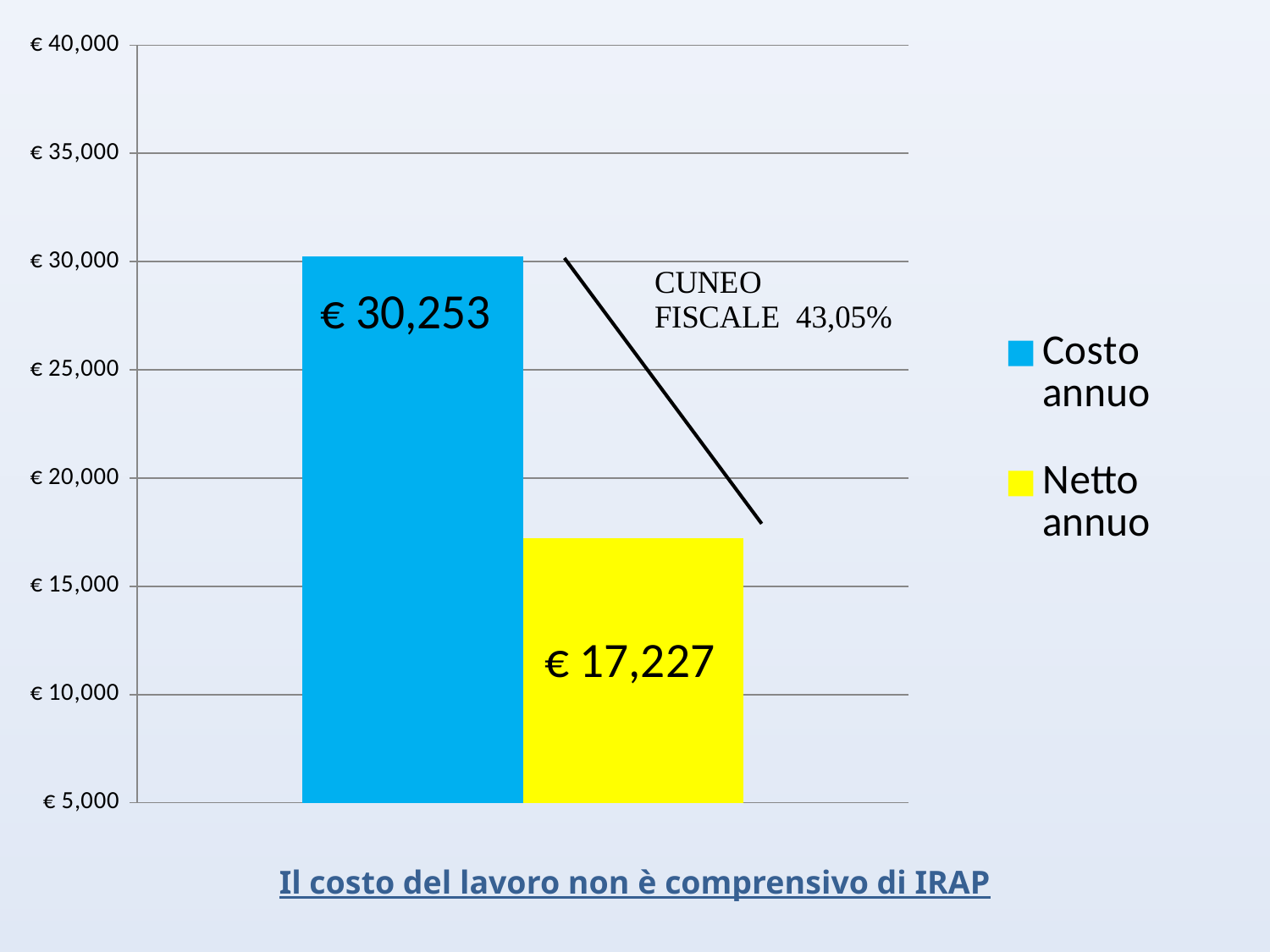
What is the difference between the Costo annuo and Netto annuo values? € 13,026 What is the value of the Costo annuo bar? € 30,253 How many series does the legend list? 2 What kind of chart is shown on the slide? Bar chart What percentage is given for the CUNEO FISCALE annotation on the chart? 43,05% What is the value of the Netto annuo bar? € 17,227 How many bars are plotted in the chart? 2 Is the value for Netto annuo greater or less than € 20,000? less Is the value for Costo annuo greater or less than € 30,000? greater What colour is the Netto annuo bar? Yellow Which series has the higher value, Costo annuo or Netto annuo? Costo annuo Which bar shows the lowest value? Netto annuo